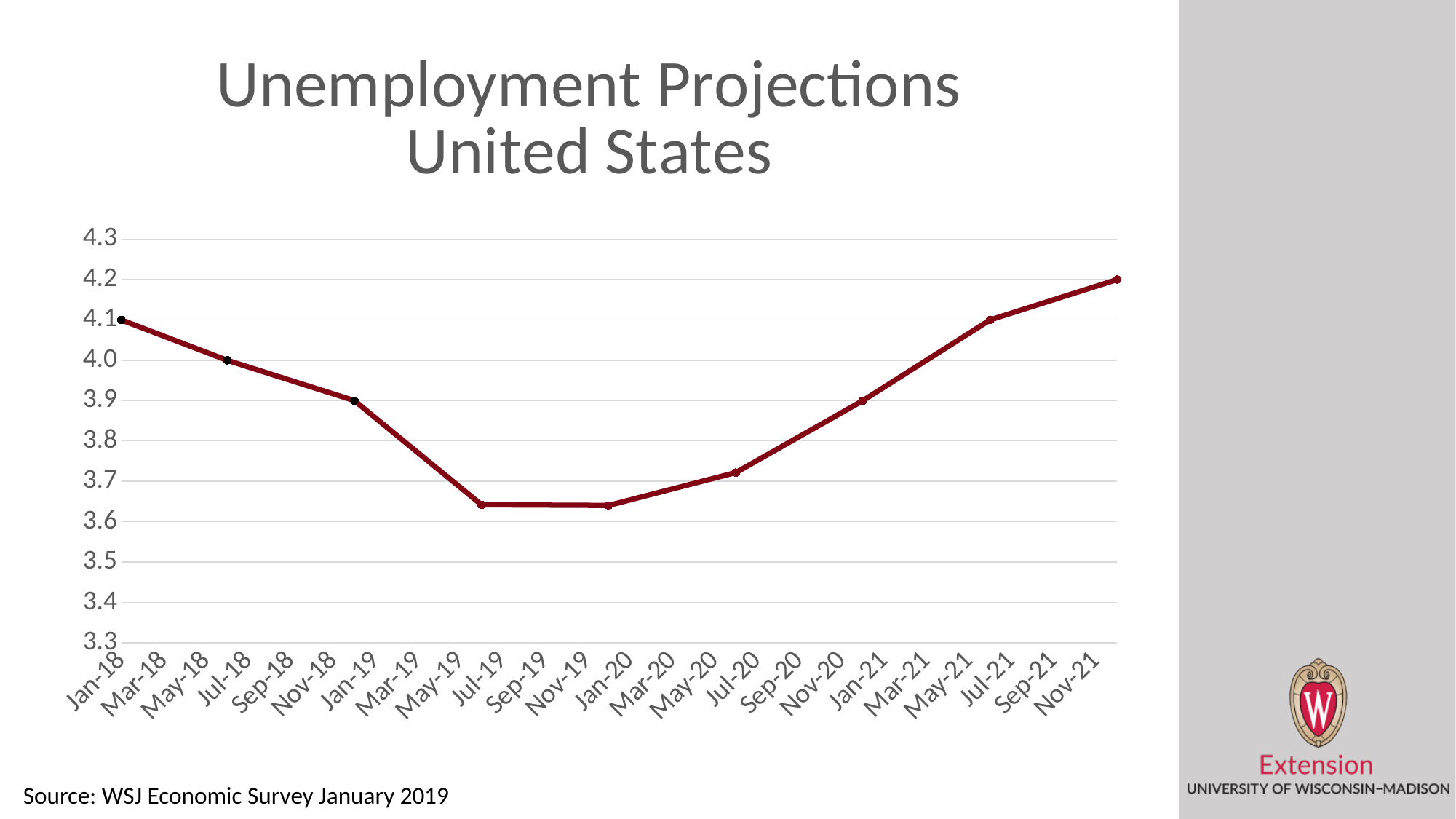
How many data points are plotted on the line? 9 What kind of chart is shown on the slide? line chart What is the value for Jan-18? 4.1 Which is larger, the value for Jan-18 or the value for Jan-19? Jan-18 Is the value for Jul-19 greater or less than 3.7? less Is the value for Jul-20 greater or less than 3.7? greater What is the title of the chart? Unemployment Projections United States